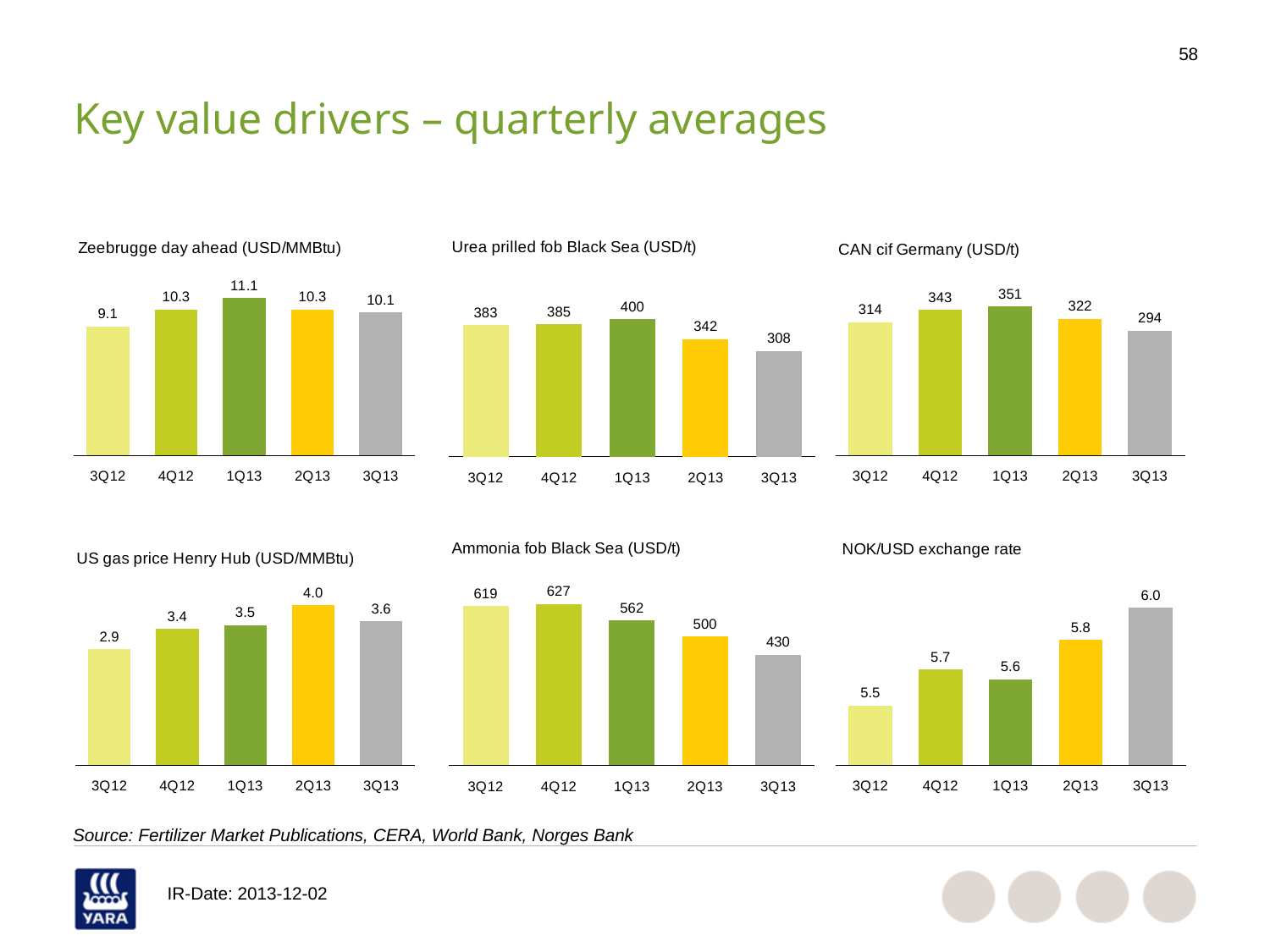
In the Ammonia fob Black Sea (USD/t) chart, do the values rise or fall from 1Q13 to 3Q13? fall In the Urea prilled fob Black Sea (USD/t) chart, which quarter has the highest value? 1Q13 In the CAN cif Germany (USD/t) chart, what is the difference between the 1Q13 and 3Q12 values? 37 In the NOK/USD exchange rate chart, what is the value for 3Q13? 6.0 In the Zeebrugge day ahead (USD/MMBtu) chart, what is the value for 1Q13? 11.1 How many quarters are shown in the CAN cif Germany (USD/t) chart? 5 In the US gas price Henry Hub (USD/MMBtu) chart, which is larger, the value for 2Q13 or the value for 3Q13? 2Q13 In the Urea prilled fob Black Sea (USD/t) chart, what is the value for 2Q13? 342 In the CAN cif Germany (USD/t) chart, which quarter has the lowest value? 3Q13 What type of chart is the Urea prilled fob Black Sea (USD/t) chart? bar chart How many charts are shown on the slide? 6 In the Ammonia fob Black Sea (USD/t) chart, what is the difference between the 4Q12 and 3Q13 values? 197